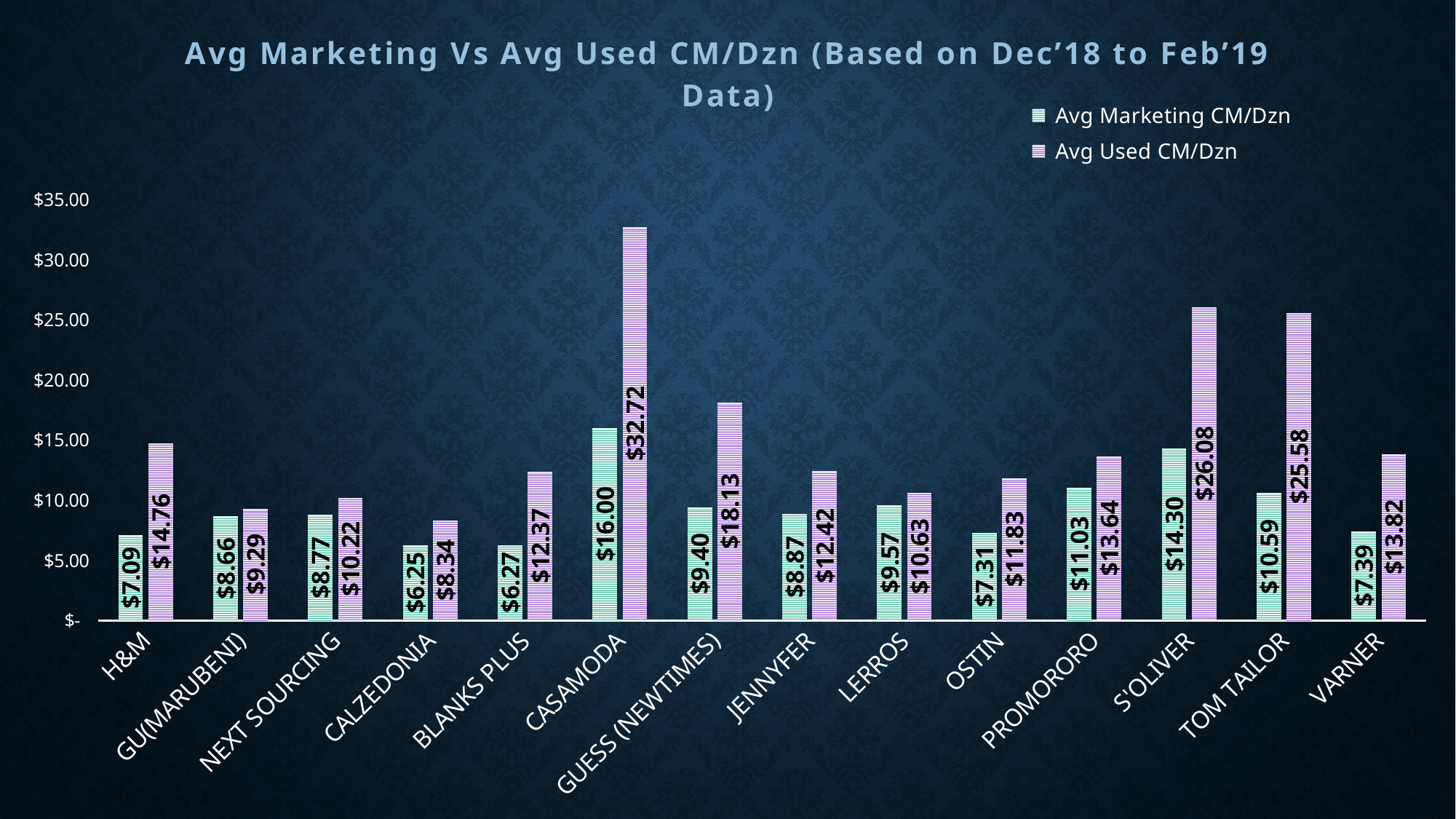
What is the Avg Marketing CM/Dzn value for TOM TAILOR? $10.59 What is the Avg Used CM/Dzn value for H&M? $14.76 Which is larger: the Avg Marketing CM/Dzn for PROMORORO or for LERROS? PROMORORO What is the difference between Avg Used CM/Dzn and Avg Marketing CM/Dzn for CASAMODA? $16.72 How many series does the legend list? 2 Which category has the highest Avg Marketing CM/Dzn? CASAMODA How many categories are shown on the x axis? 14 Which category has the highest Avg Used CM/Dzn? CASAMODA Which category has the lowest Avg Used CM/Dzn? CALZEDONIA Is the Avg Used CM/Dzn value for S'OLIVER greater or less than $20.00? greater What is the Avg Used CM/Dzn value for CASAMODA? $32.72 What kind of chart is shown on the slide? Bar chart